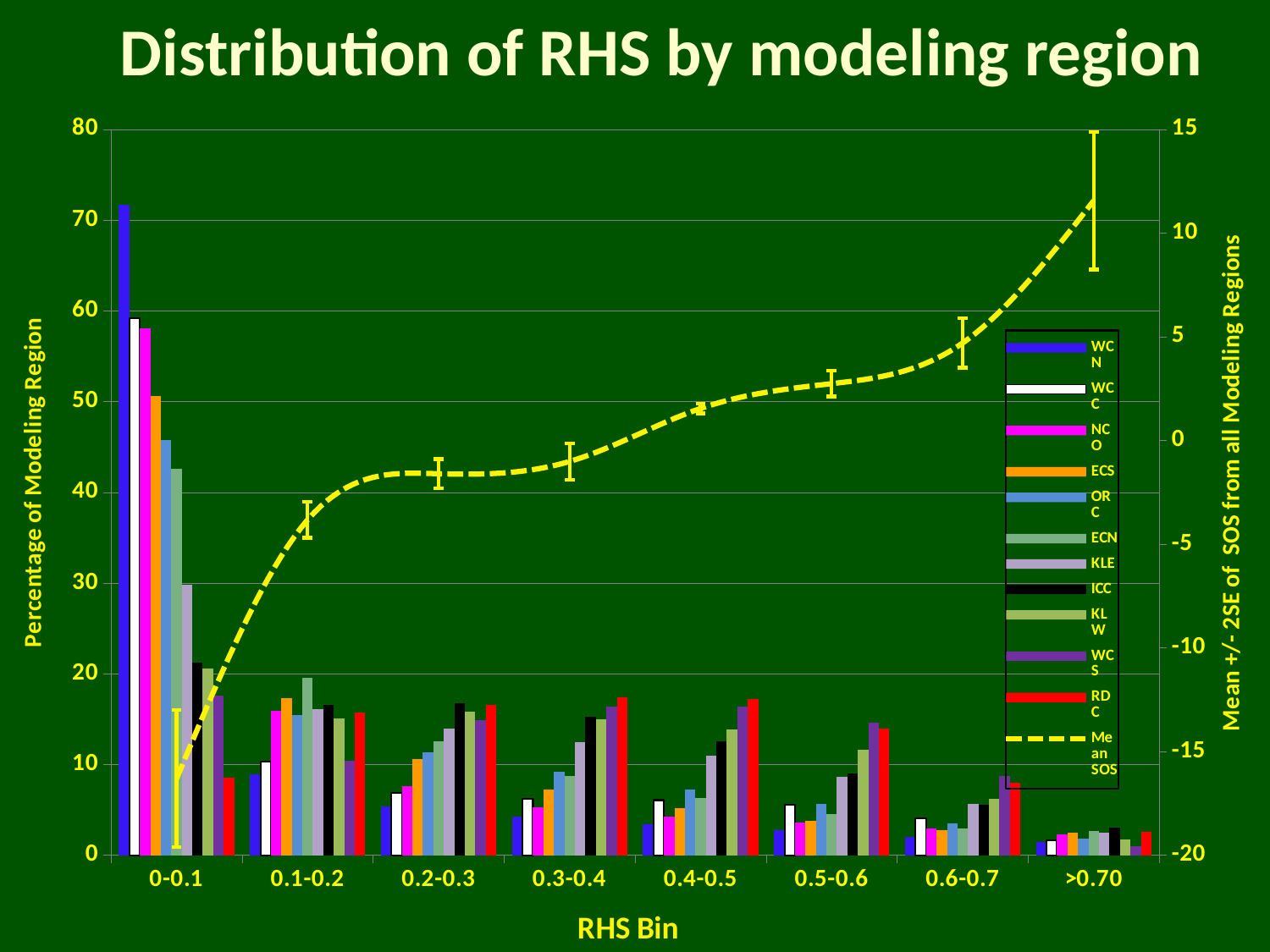
How many series does the legend list? 12 Does the Mean SOS line rise or fall as the RHS bin increases along the x axis? rise What is the title of the chart? Distribution of RHS by modeling region In the 0-0.1 bin, which is larger, WCN or WCC? WCN Is the value for ORC in the 0-0.1 bin greater or less than 50? less Which region has the highest bar in the 0-0.1 bin? WCN How many RHS bins are shown on the x axis? 8 What kind of chart is this? Bar chart with a dashed line series Is the value for RDC in the 0-0.1 bin greater or less than 10? less Is the value for WCN in the 0-0.1 bin greater or less than 60? greater What is the label of the x axis? RHS Bin Which RHS bin contains the tallest bar on the chart? 0-0.1